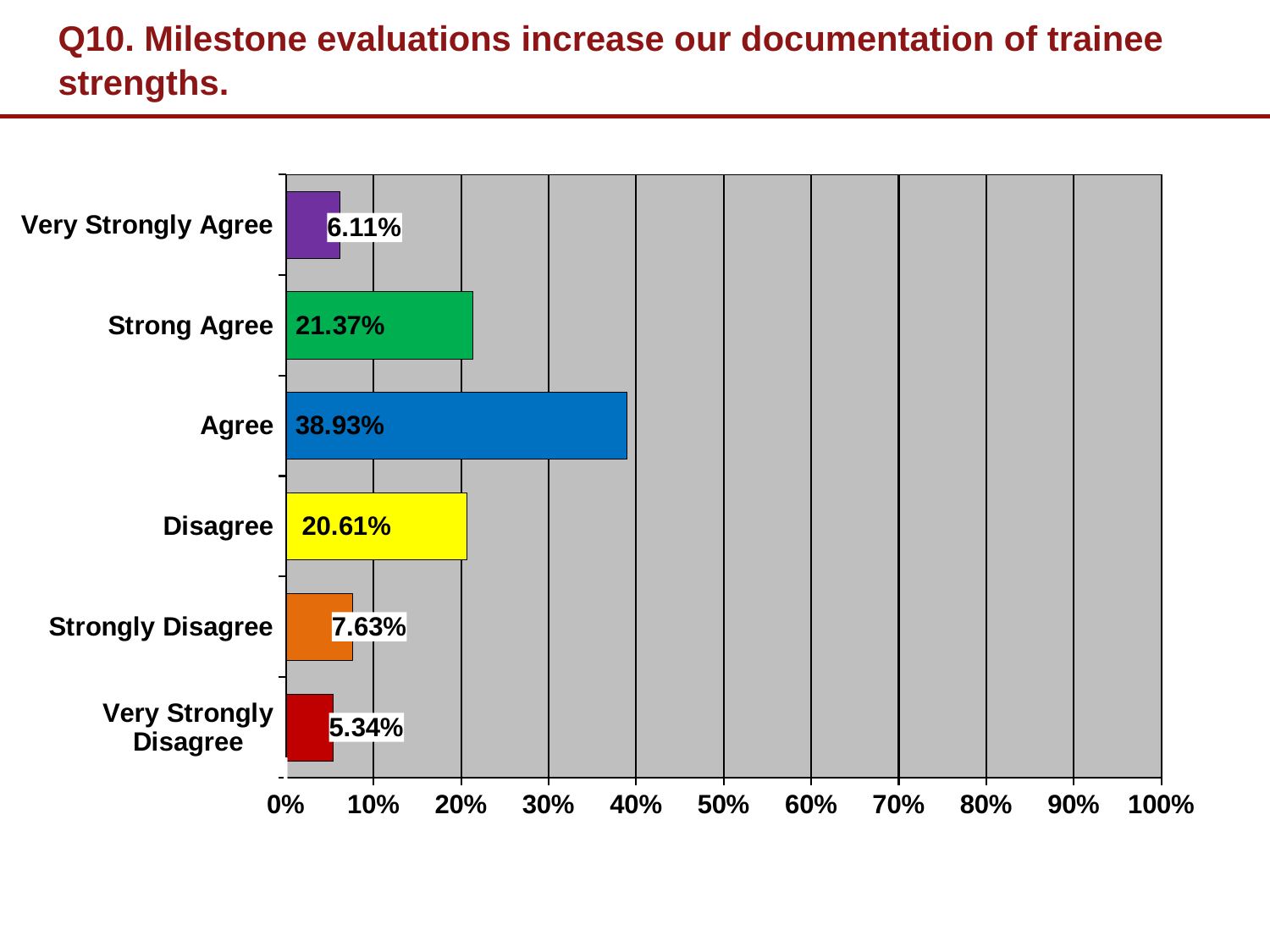
What kind of chart is shown on the slide? Bar chart Which response category has the highest percentage? Agree How many response categories are shown in the chart? 6 What is the title of the slide? Q10. Milestone evaluations increase our documentation of trainee strengths. What percentage is shown for "Strong Agree"? 21.37% Which is larger, the value for "Strongly Disagree" or the value for "Very Strongly Agree"? Strongly Disagree What is the value for "Strongly Disagree"? 7.63% What is the value shown for "Very Strongly Disagree"? 5.34% What is the difference between the "Agree" and "Disagree" percentages? 18.32% Is the value for "Agree" greater or less than 30%? greater What percentage of respondents chose "Agree"? 38.93% Which response category has the lowest percentage? Very Strongly Disagree